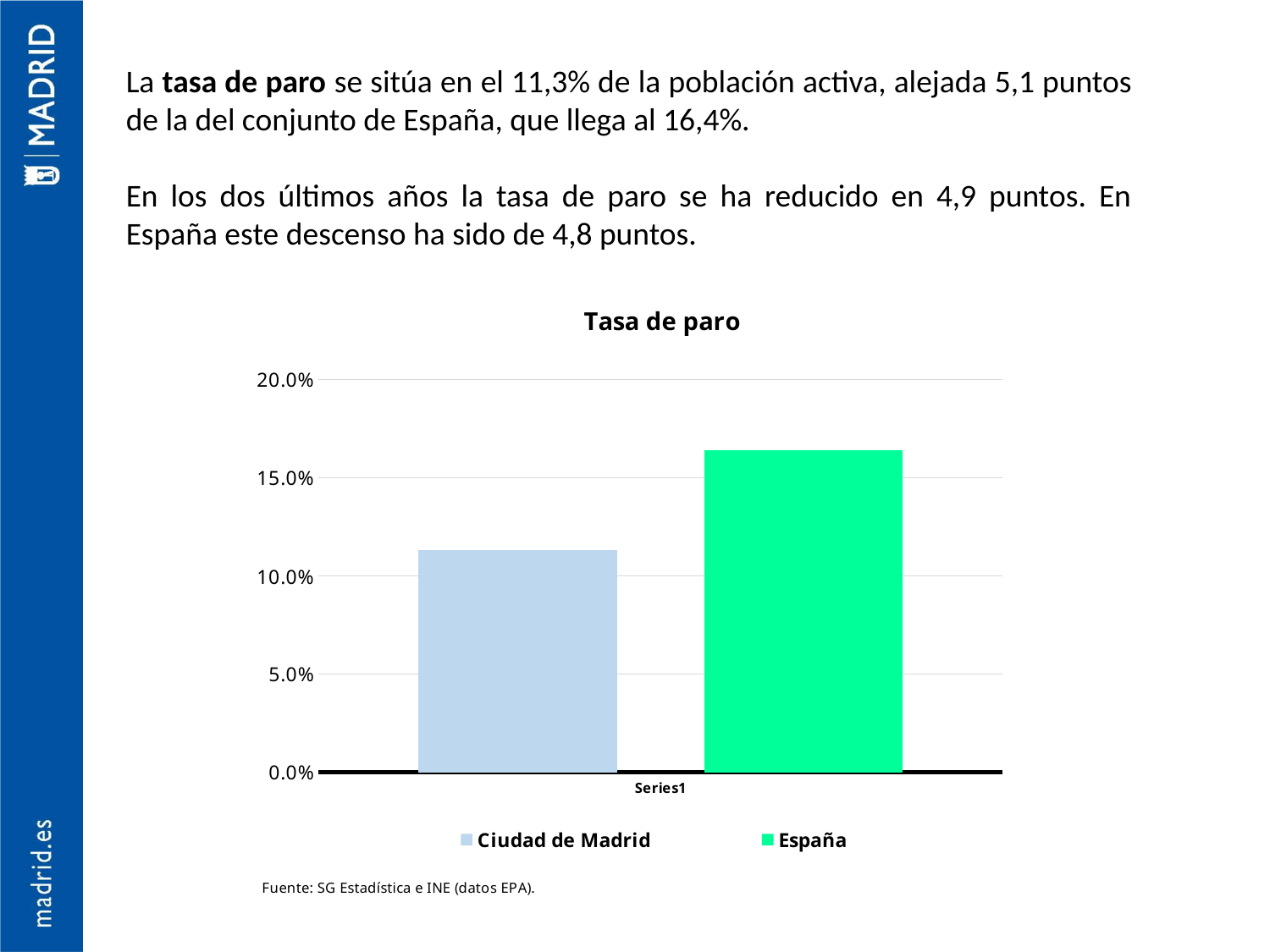
How many bars are plotted in the chart? 2 What is the title of the chart? Tasa de paro What is the highest tick value shown on the vertical axis? 20.0% Is the value for España greater or less than 15.0%? greater Which is larger, the bar for Ciudad de Madrid or the bar for España? España Is the value for España greater or less than 20.0%? less Which series has the highest bar in the chart? España How many series does the legend list? 2 What kind of chart is shown on the slide? bar chart Is the value for Ciudad de Madrid greater or less than 10.0%? greater Which series has the lowest bar in the chart? Ciudad de Madrid